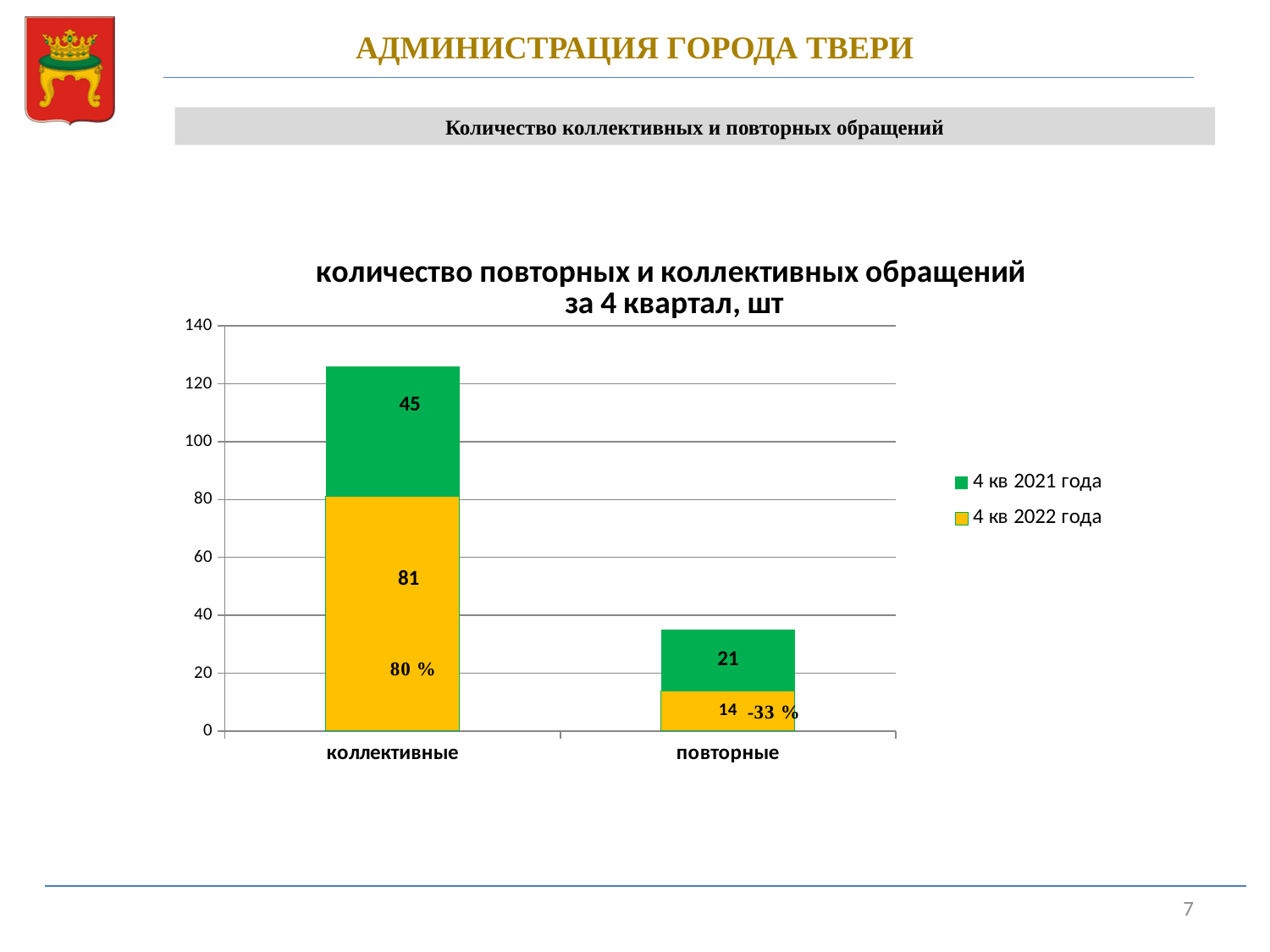
What is the total of the stacked bar for коллективные? 126 What is the value for повторные in the 4 кв 2022 года series? 14 What is the value for повторные in the 4 кв 2021 года series? 21 What is the value for коллективные in the 4 кв 2021 года series? 45 What kind of chart is shown on the slide? stacked bar chart What is the value for коллективные in the 4 кв 2022 года series? 81 Which is larger for повторные: the 4 кв 2021 года value or the 4 кв 2022 года value? 4 кв 2021 года Which category has the highest total stacked bar? коллективные What is the total of the stacked bar for повторные? 35 How many series does the legend list? 2 What is the difference between the 4 кв 2022 года and 4 кв 2021 года values for коллективные? 36 How many categories are shown on the x axis? 2